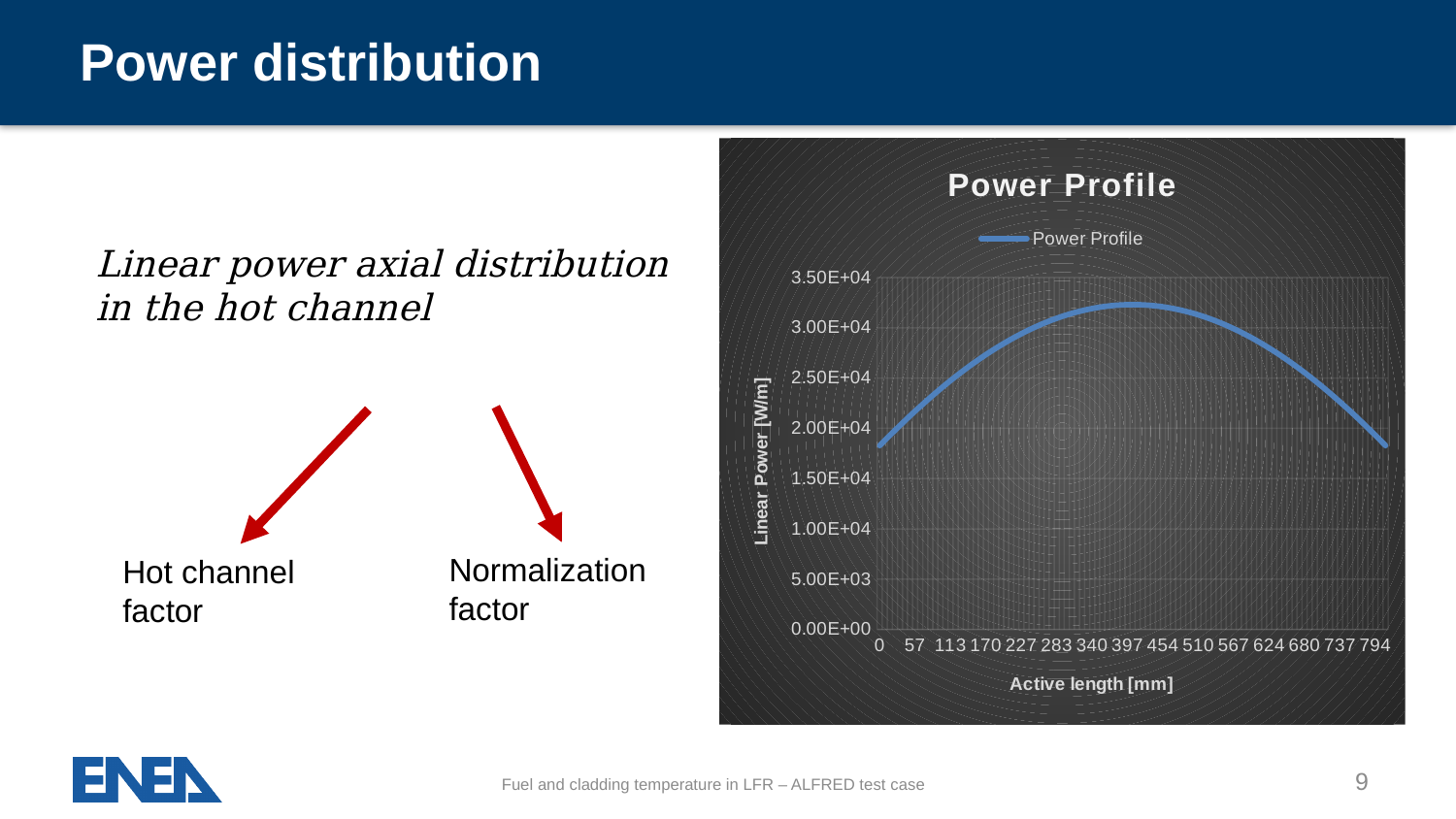
What is the title of the chart on the slide? Power Profile Is the peak value of the Power Profile curve greater or less than 3.50E+04? less What is the label of the y axis of the Power Profile chart? Linear Power [W/m] How many series does the legend of the Power Profile chart list? 1 Which is larger in the Power Profile chart: the value at active length 0 mm or at 397 mm? 397 mm Is the value of Power Profile at active length 397 mm greater or less than 3.00E+04? greater Is the value of Power Profile at active length 0 mm greater or less than 2.00E+04? less How many tick labels are shown on the x axis of the Power Profile chart? 15 What kind of chart is the Power Profile chart? line chart How does the Power Profile curve behave as active length increases from 0 to 794 mm? rises then falls